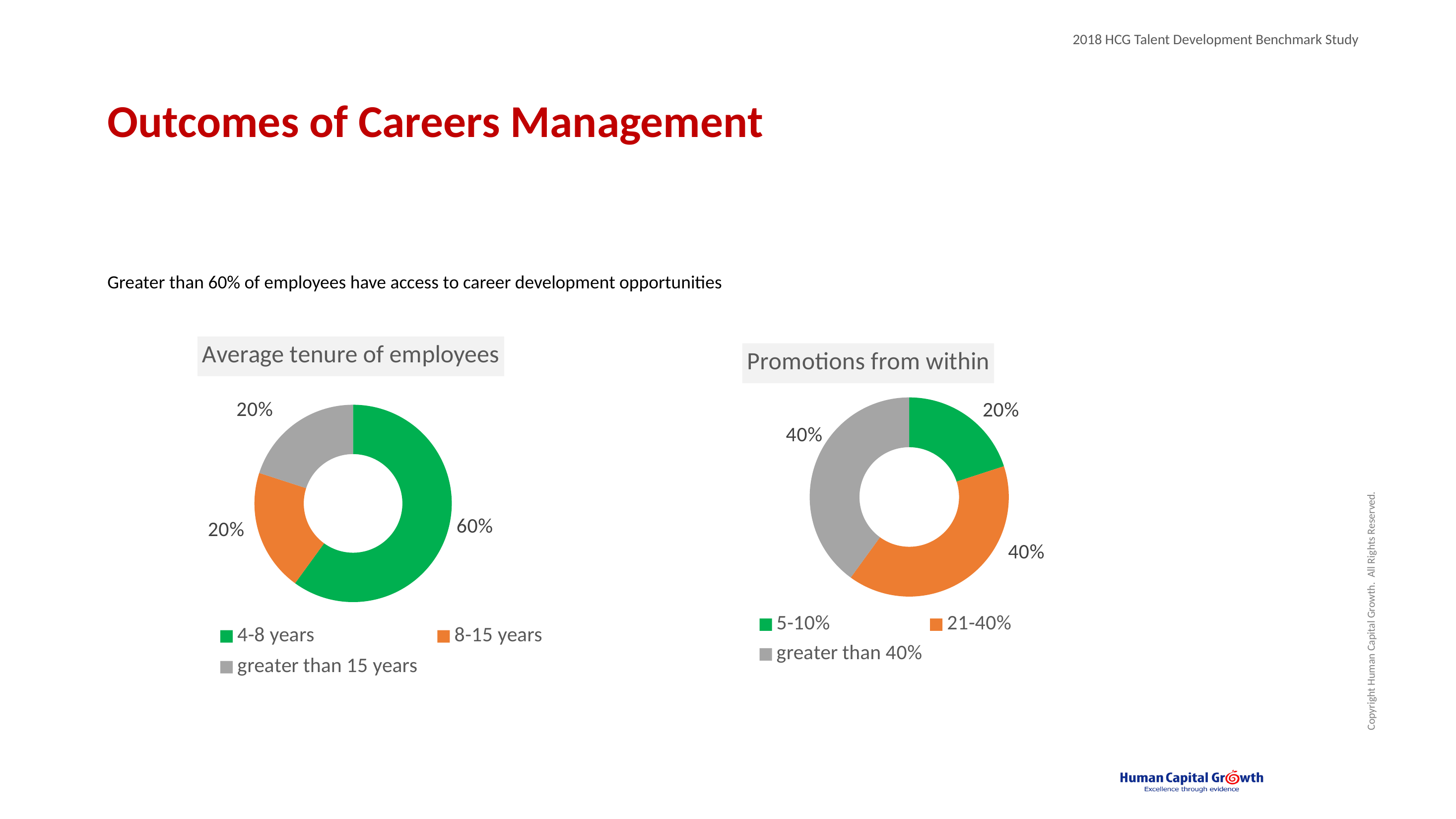
In the 'Average tenure of employees' chart, what share is labelled for 8-15 years? 20% In the 'Promotions from within' chart, which is larger: the share for 21-40% or the share for 5-10%? 21-40% In the 'Promotions from within' chart, which category has the smallest share? 5-10% In the 'Promotions from within' chart, what colour is the 21-40% slice? Orange In the 'Promotions from within' chart, what share is labelled for 5-10%? 20% In the 'Average tenure of employees' chart, which category has the largest share? 4-8 years In the 'Average tenure of employees' chart, how many categories does the legend list? 3 In the 'Average tenure of employees' chart, what is the difference between the 4-8 years share and the greater than 15 years share? 40% In the 'Promotions from within' chart, what share is labelled for greater than 40%? 40% How many charts are shown on the slide? 2 In the 'Average tenure of employees' chart, what share is labelled for 4-8 years? 60% What kind of chart is 'Average tenure of employees'? Doughnut chart